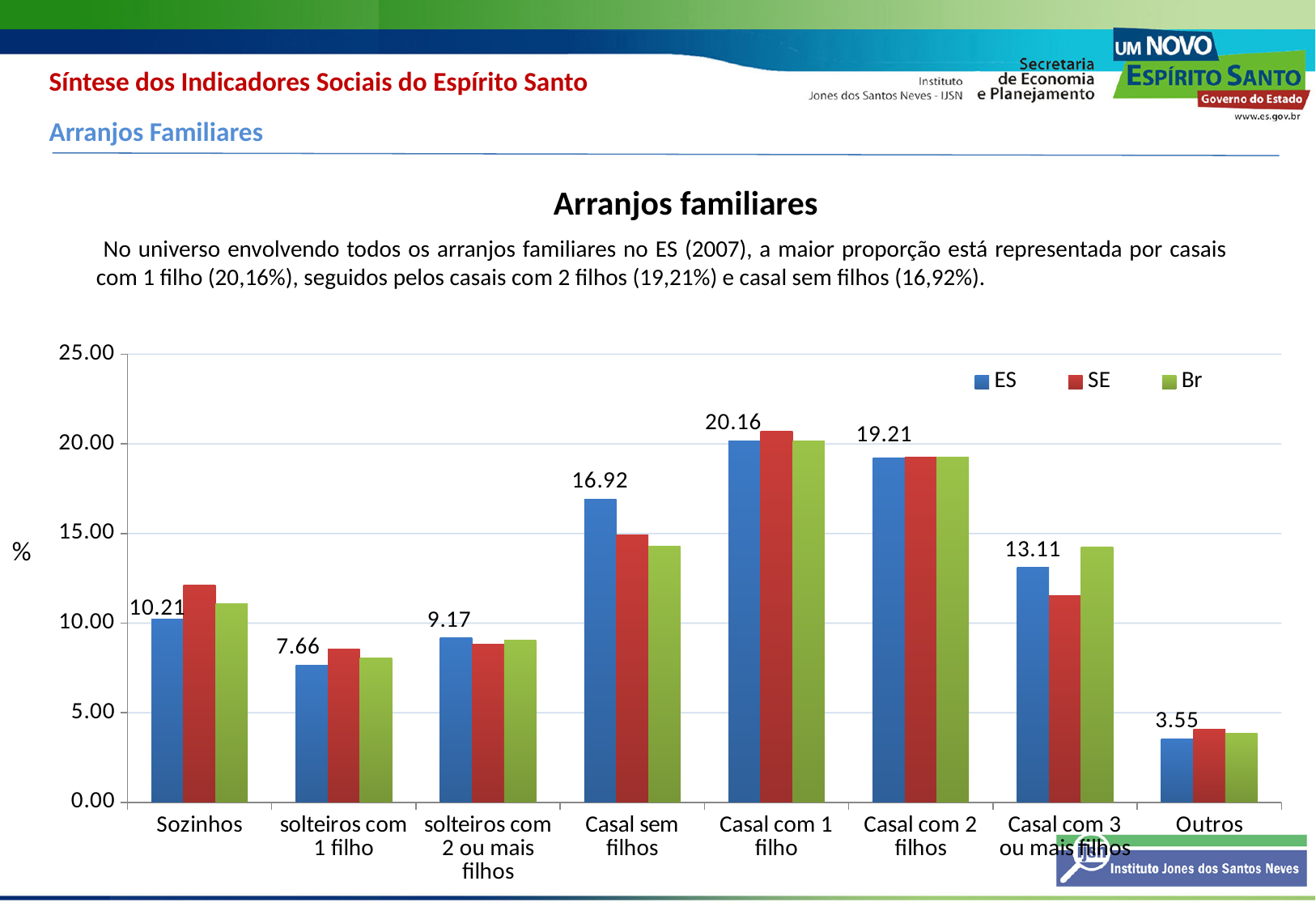
What is the ES value for 'Outros'? 3.55 What type of chart is shown on the slide? bar chart How many series does the legend list? 3 How many categories are shown on the x axis? 8 What label is shown on the vertical axis? % What is the ES value for 'Sozinhos'? 10.21 What is the difference between the ES values for 'Casal com 1 filho' and 'Casal com 2 filhos'? 0.95 Which category has the highest ES value? Casal com 1 filho Is the SE value for 'Casal com 3 ou mais filhos' greater or less than 15.00? less What is the ES value for 'Casal com 1 filho'? 20.16 Which is larger for ES: 'Casal sem filhos' or 'Casal com 3 ou mais filhos'? Casal sem filhos Which category has the lowest ES value? Outros